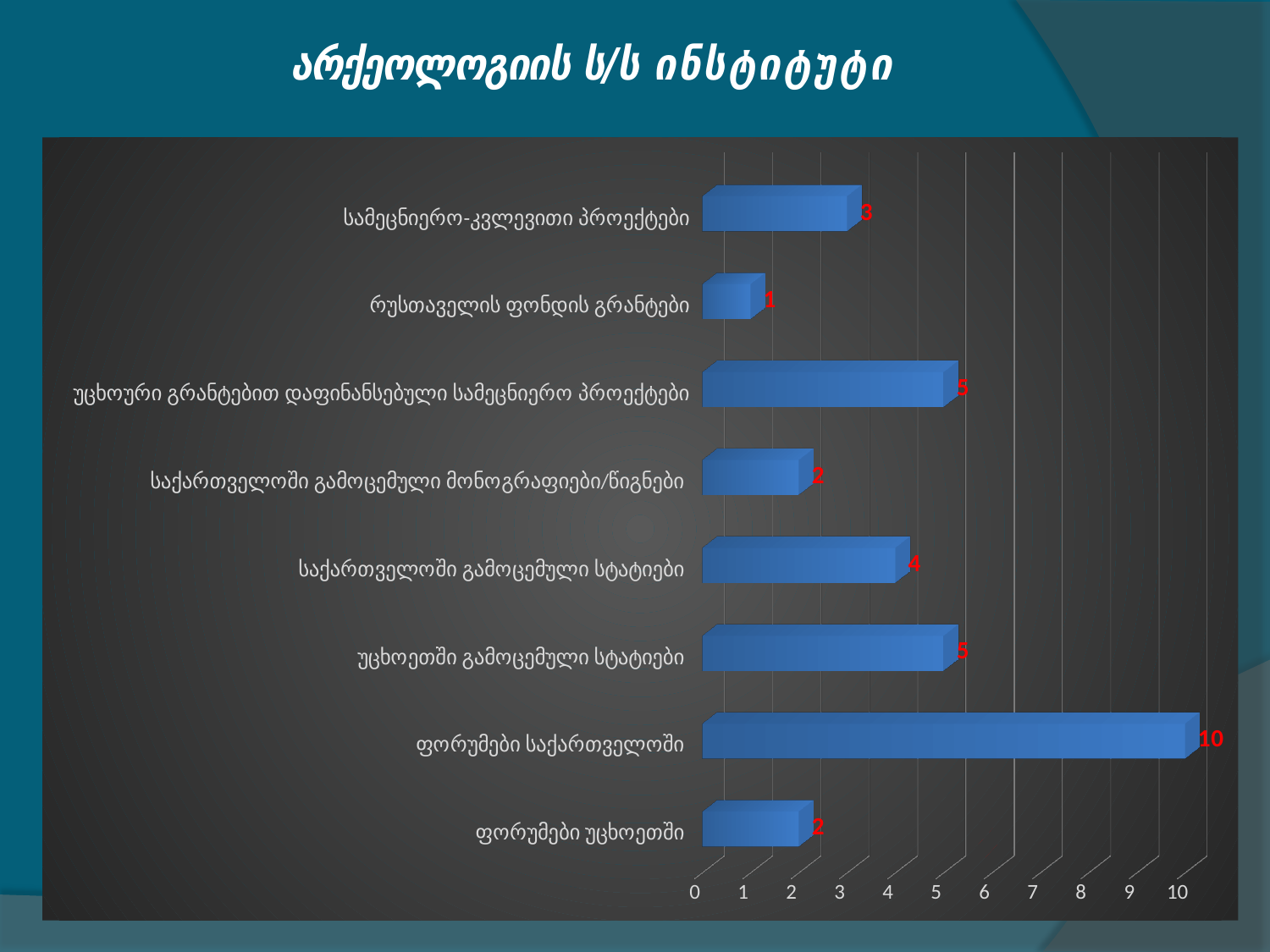
What is the title of the slide? არქეოლოგიის ს/ს ინსტიტუტი What is the highest value shown on the horizontal axis? 10 What value is shown for სამეცნიერო-კვლევითი პროექტები? 3 Which category has the highest value? ფორუმები საქართველოში How many categories are shown in the chart? 8 Which category has the lowest value? რუსთაველის ფონდის გრანტები What value is shown for ფორუმები საქართველოში? 10 What kind of chart is shown on the slide? bar chart Which is larger: the value for უცხოეთში გამოცემული სტატიები or the value for საქართველოში გამოცემული სტატიები? უცხოეთში გამოცემული სტატიები What value is shown for რუსთაველის ფონდის გრანტები? 1 What is the difference between the values for ფორუმები საქართველოში and ფორუმები უცხოეთში? 8 What value is shown for საქართველოში გამოცემული სტატიები? 4